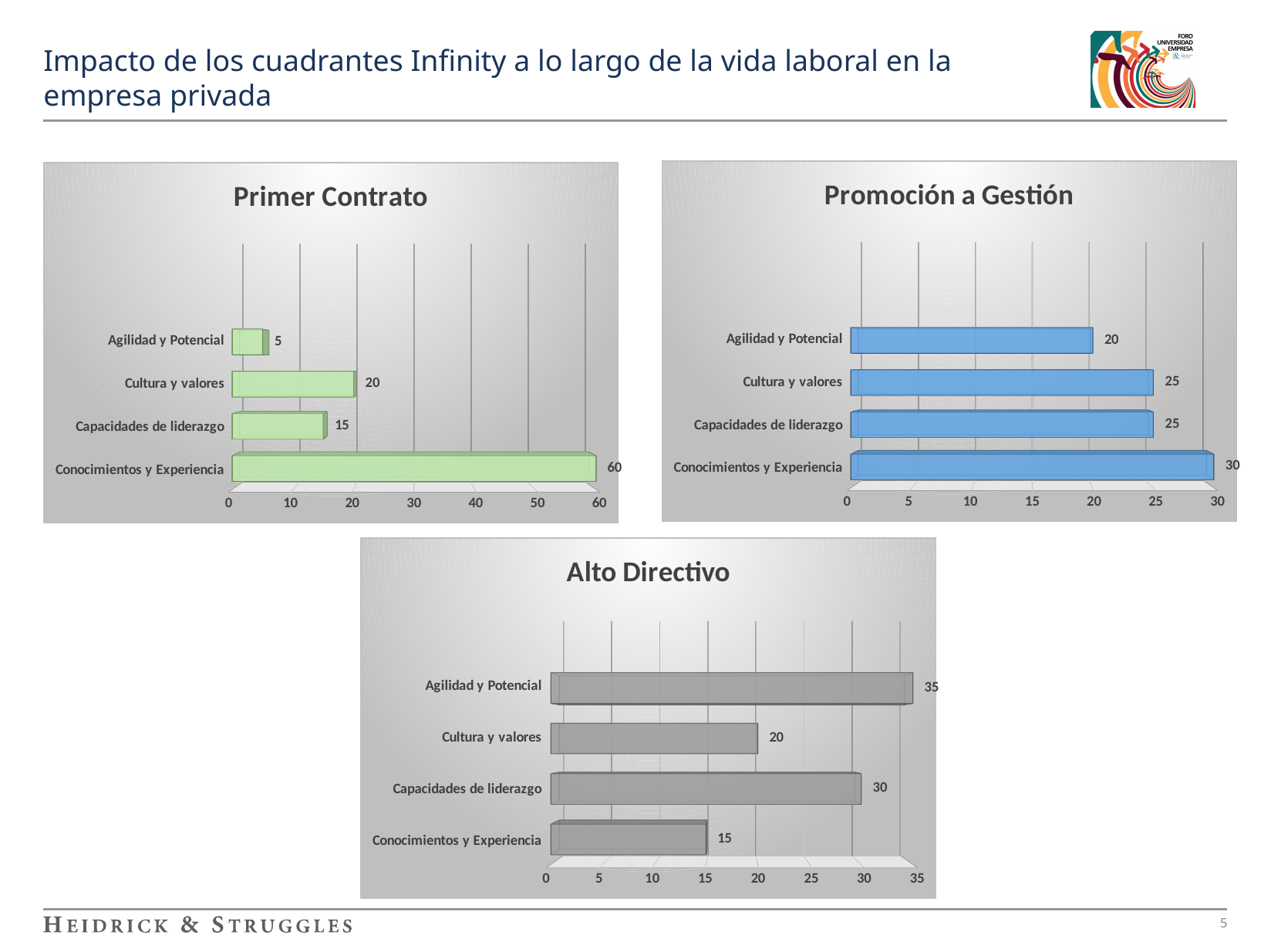
In the 'Promoción a Gestión' chart, what is the value for Agilidad y Potencial? 20 In the 'Alto Directivo' chart, what is the value for Capacidades de liderazgo? 30 What is the title of the chart at the bottom of the slide? Alto Directivo In the 'Promoción a Gestión' chart, which category has the highest value? Conocimientos y Experiencia In the 'Alto Directivo' chart, which is larger: Cultura y valores or Conocimientos y Experiencia? Cultura y valores In the 'Primer Contrato' chart, which category has the lowest value? Agilidad y Potencial In the 'Primer Contrato' chart, what is the difference between Cultura y valores and Capacidades de liderazgo? 5 In the 'Alto Directivo' chart, what is the difference between Agilidad y Potencial and Conocimientos y Experiencia? 20 In the 'Promoción a Gestión' chart, how many categories are shown? 4 In the 'Primer Contrato' chart, what is the value for Conocimientos y Experiencia? 60 In the 'Alto Directivo' chart, which category has the highest value? Agilidad y Potencial What kind of chart is the 'Primer Contrato' chart? Bar chart